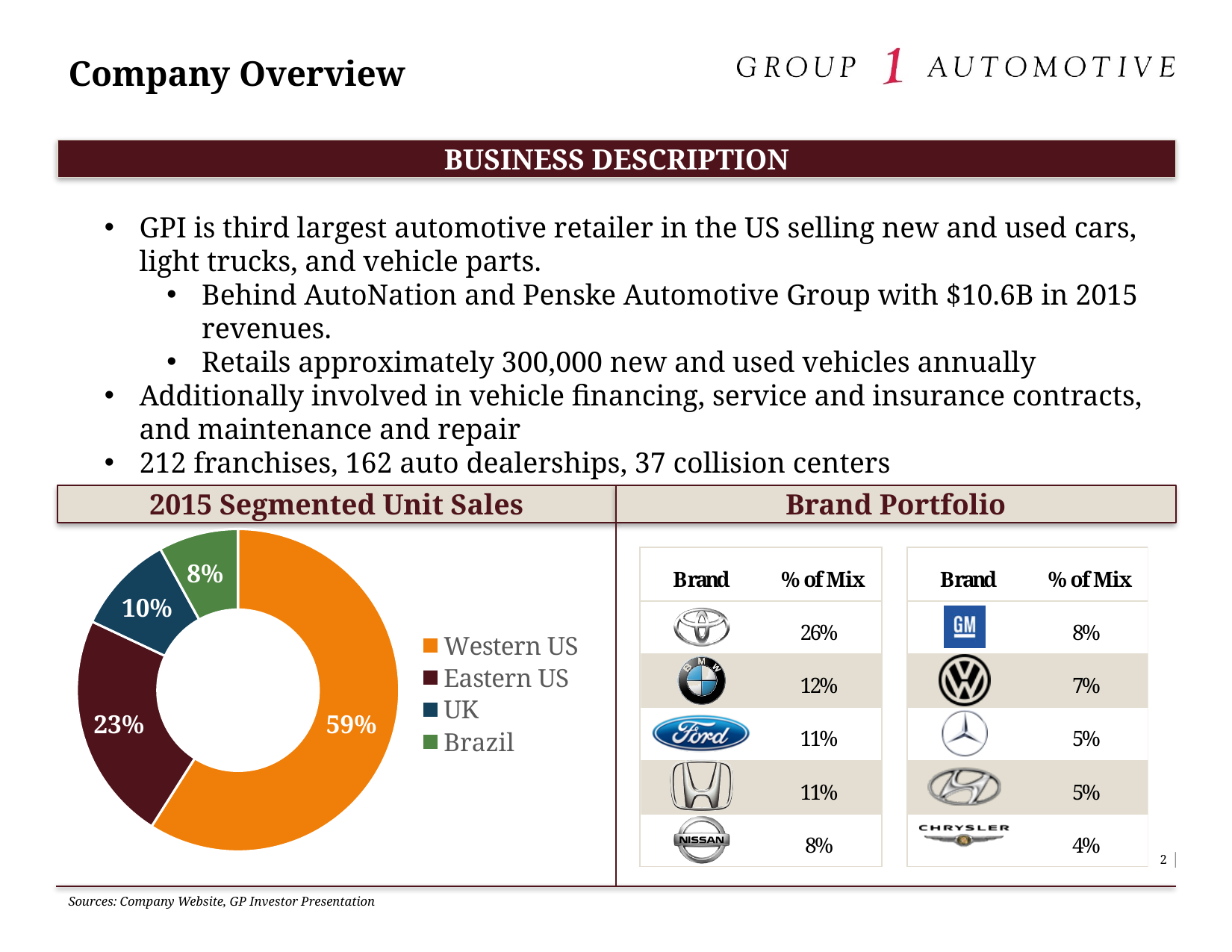
What type of chart is used to show 2015 Segmented Unit Sales? Pie (donut) chart What is the UK's share of 2015 segmented unit sales? 10% What colour represents Western US in the 2015 Segmented Unit Sales chart? Orange How many segments are shown in the 2015 Segmented Unit Sales chart? 4 Which segment has the smallest share of 2015 segmented unit sales? Brazil Which has a larger share of 2015 segmented unit sales, UK or Brazil? UK What percentage of 2015 segmented unit sales is attributed to Eastern US? 23% What is Brazil's share of 2015 segmented unit sales? 8% What is the difference in percentage points between the Western US and Eastern US shares of 2015 unit sales? 36 Which segment has the largest share of 2015 segmented unit sales? Western US What share of 2015 segmented unit sales does Western US account for? 59% How many entries does the legend of the 2015 Segmented Unit Sales chart list? 4